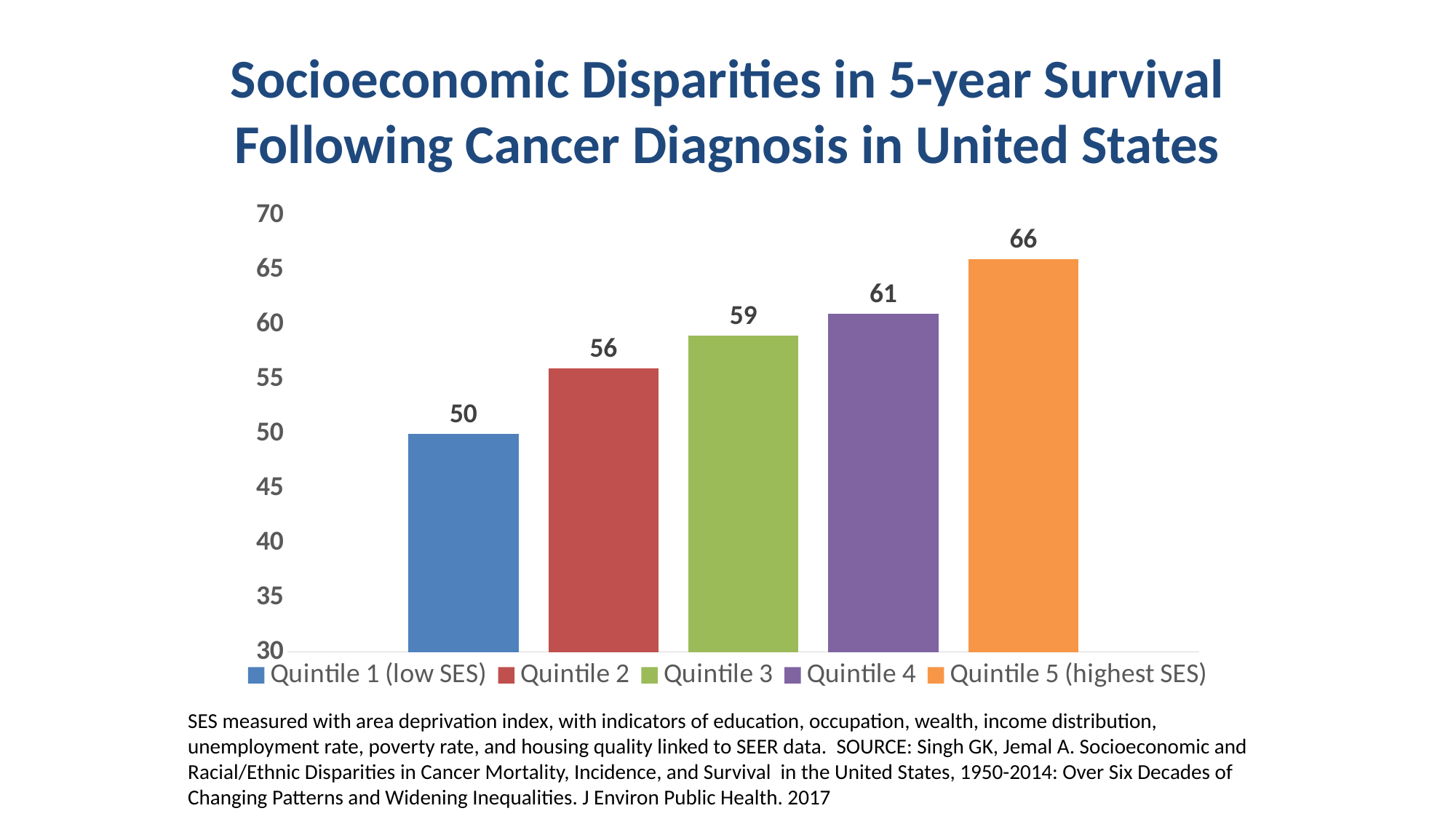
How many quintiles are plotted in the chart? 5 What kind of chart is shown on the slide? bar chart Is the value for Quintile 2 greater or less than 60? less Do the values rise or fall from Quintile 1 to Quintile 5? rise What is the difference between the values for Quintile 5 (highest SES) and Quintile 1 (low SES)? 16 Which quintile has the lowest 5-year survival value? Quintile 1 (low SES) What is the value shown for Quintile 5 (highest SES)? 66 What is the 5-year survival value for Quintile 1 (low SES)? 50 What is the difference between the values for Quintile 4 and Quintile 2? 5 Which quintile has the highest 5-year survival value? Quintile 5 (highest SES) What is the value shown for Quintile 3? 59 Which has a larger value, Quintile 2 or Quintile 4? Quintile 4